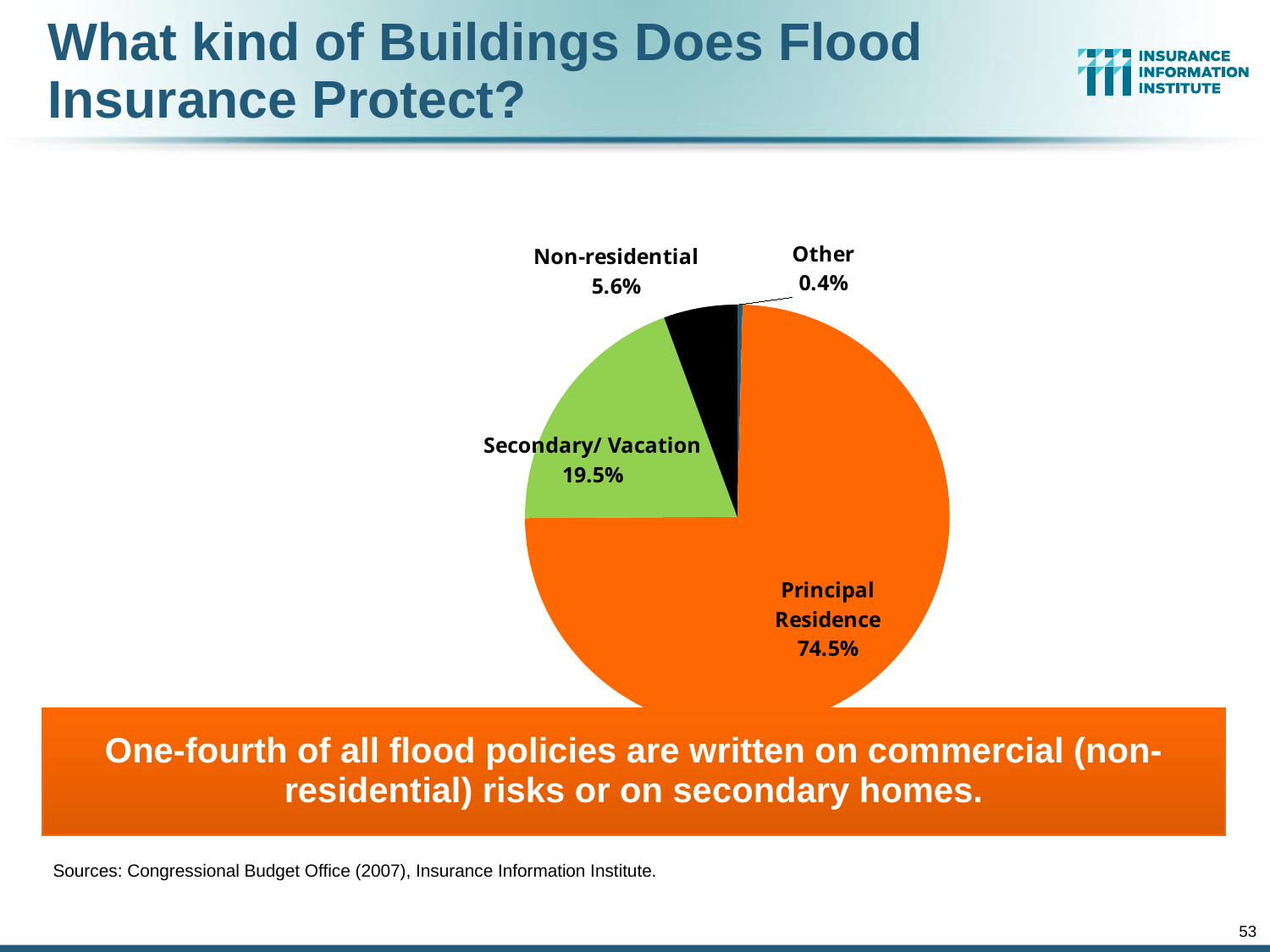
What is the value for the Other slice? 0.4% Which is larger, the Non-residential slice or the Secondary/ Vacation slice? Secondary/ Vacation What colour is the Secondary/ Vacation slice? Green What is the difference between the Principal Residence and Secondary/ Vacation shares? 55.0 percentage points What percentage is shown for Non-residential? 5.6% What is the value shown for Secondary/ Vacation? 19.5% How many categories are shown in the pie chart? 4 What type of chart is shown on the slide? Pie chart Which category has the largest slice of the pie? Principal Residence What share of the pie does Principal Residence account for? 74.5% Which category has the smallest slice of the pie? Other What is the combined share of Non-residential and Secondary/ Vacation? 25.1%